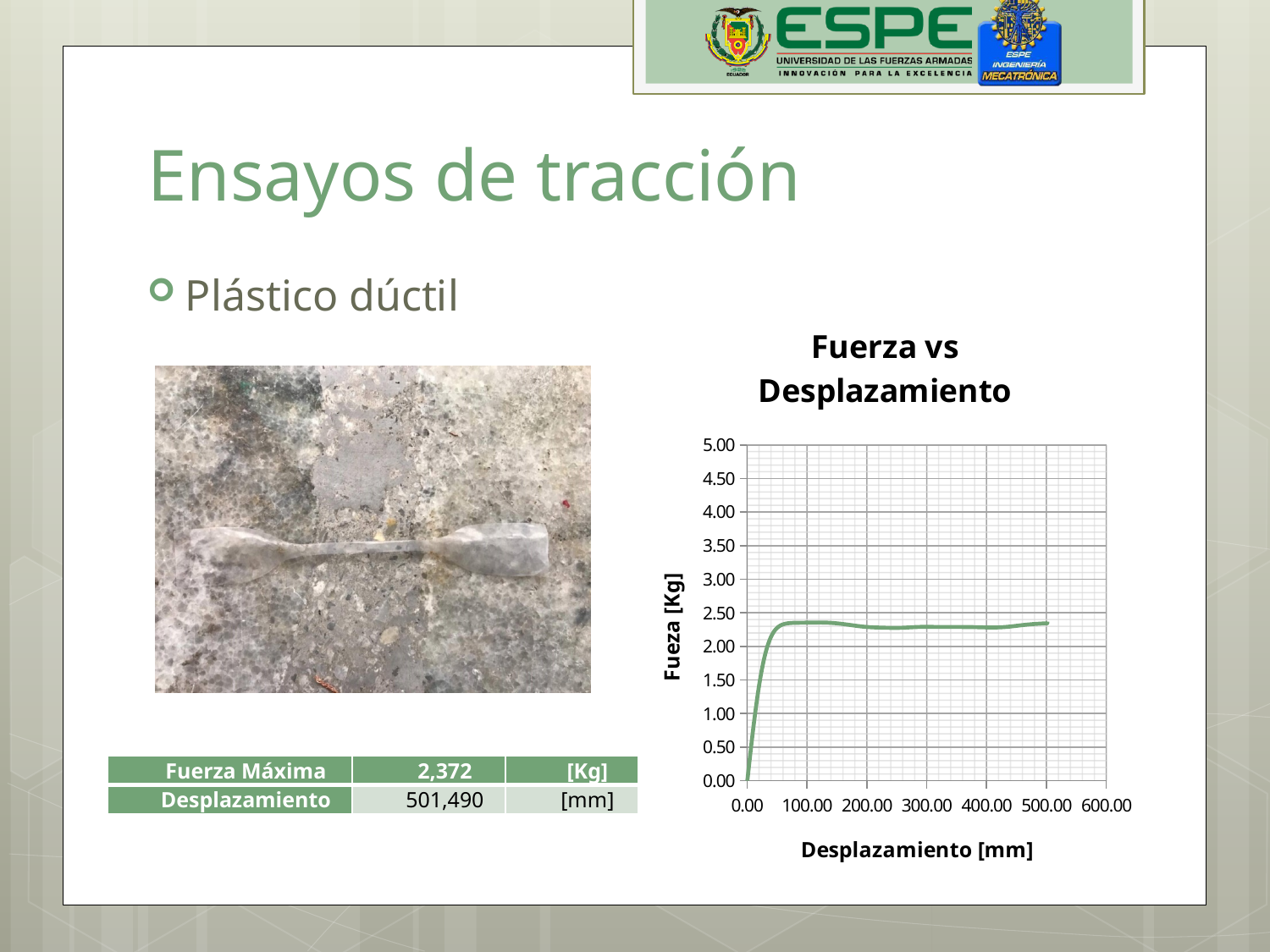
Is the value of the curve at 400.00 mm greater or less than 1.50 Kg? greater Is the value of the curve at 300.00 mm greater or less than 2.00 Kg? greater Does the force rise or fall between 0.00 mm and 50.00 mm? rise Is the value of the curve at 100.00 mm greater or less than 2.00 Kg? greater What kind of chart is shown on the slide? line chart How does the force change along the x axis after the initial rise? it stays roughly flat What is the title of the chart? Fuerza vs Desplazamiento What is the label of the x axis of the chart? Desplazamiento [mm] What is the highest tick value shown on the y axis? 5.00